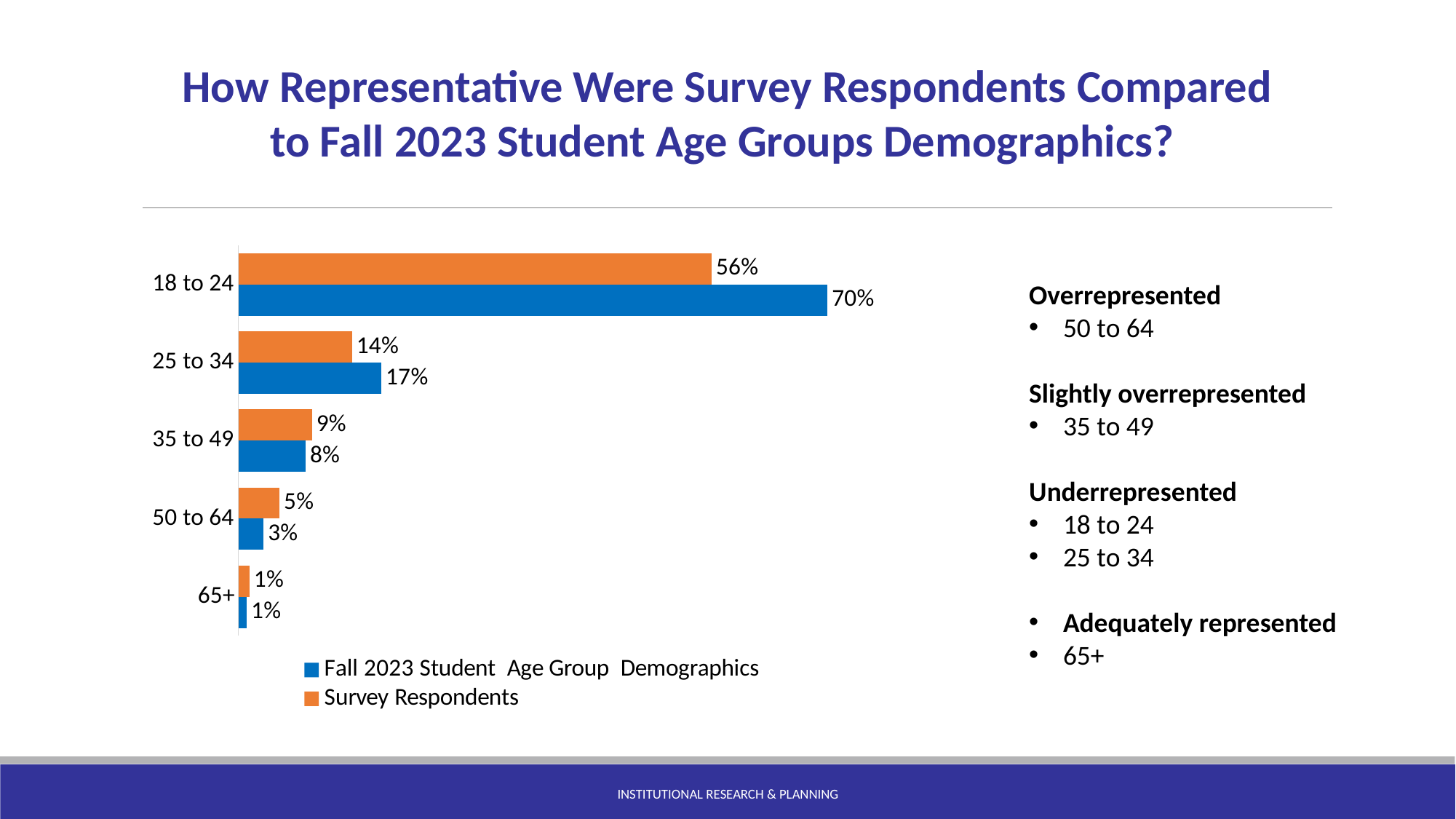
What is the difference between the Fall 2023 Student Age Group Demographics value and the Survey Respondents value for the 18 to 24 age group? 14% What kind of chart is shown on the slide? Bar chart For the 35 to 49 age group, which series has the larger value: Fall 2023 Student Age Group Demographics or Survey Respondents? Survey Respondents What is the Survey Respondents value for the 50 to 64 age group? 5% Which colour represents the Survey Respondents series in the chart? Orange How many age groups are shown on the chart? 5 What is the difference between the Survey Respondents value and the Fall 2023 Student Age Group Demographics value for the 50 to 64 age group? 2% Which age group has the lowest Survey Respondents value? 65+ What is the Survey Respondents value for the 18 to 24 age group? 56% Which age group has the highest Fall 2023 Student Age Group Demographics value? 18 to 24 How many series does the legend list? 2 What is the Fall 2023 Student Age Group Demographics value for the 25 to 34 age group? 17%